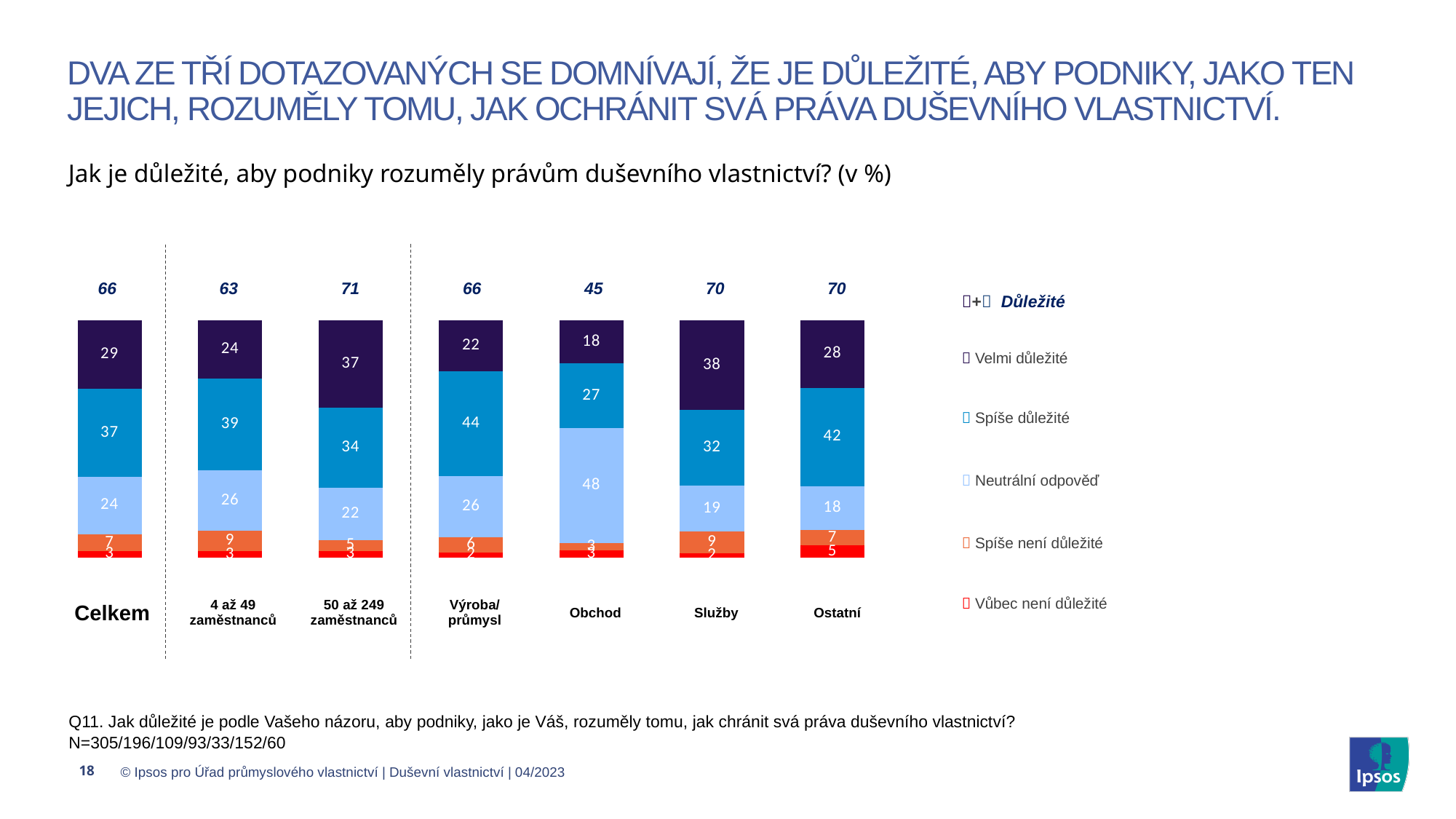
What is the value of "Velmi důležité" for Celkem? 29 What is the "Důležité" total shown above the bar for 50 až 249 zaměstnanců? 71 What kind of chart is shown on the slide? Stacked bar chart What is the difference between the "Spíše důležité" values for Výroba/průmysl and Obchod? 17 Which category has the lowest "Důležité" total shown above the bars? Obchod How many response categories does the legend list below the "Důležité" entry? 5 How many categories (bars) are shown in the chart? 7 What is the value of "Neutrální odpověď" for Obchod? 48 What is the value of "Spíše důležité" for Ostatní? 42 Which is larger, the "Velmi důležité" value for 4 až 49 zaměstnanců or for 50 až 249 zaměstnanců? 50 až 249 zaměstnanců Which category has the highest value for "Velmi důležité"? Služby What is the sum of "Velmi důležité" and "Spíše důležité" for Služby? 70